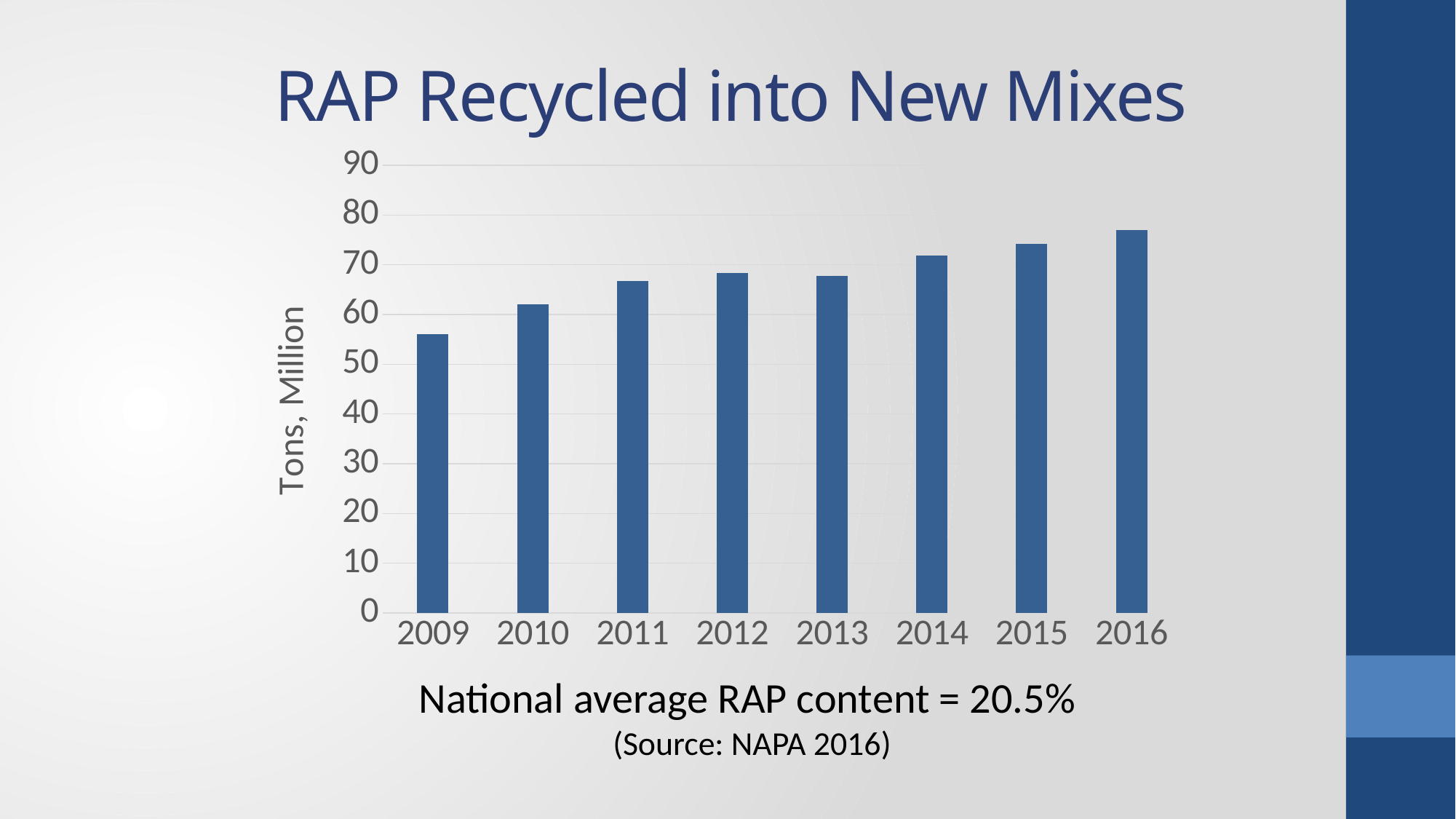
What kind of chart is shown on the slide? bar chart Which year has the larger value, 2010 or 2014? 2014 Is the value for 2015 greater or less than 70? greater Is the value for 2016 greater or less than 80? less Is the value for 2009 greater or less than 60? less Which year has the highest value for RAP recycled into new mixes? 2016 Do the values generally rise or fall from 2009 to 2016? rise How many years are plotted on the x axis? 8 What is the label on the vertical axis of the chart? Tons, Million Which year has the lowest value for RAP recycled into new mixes? 2009